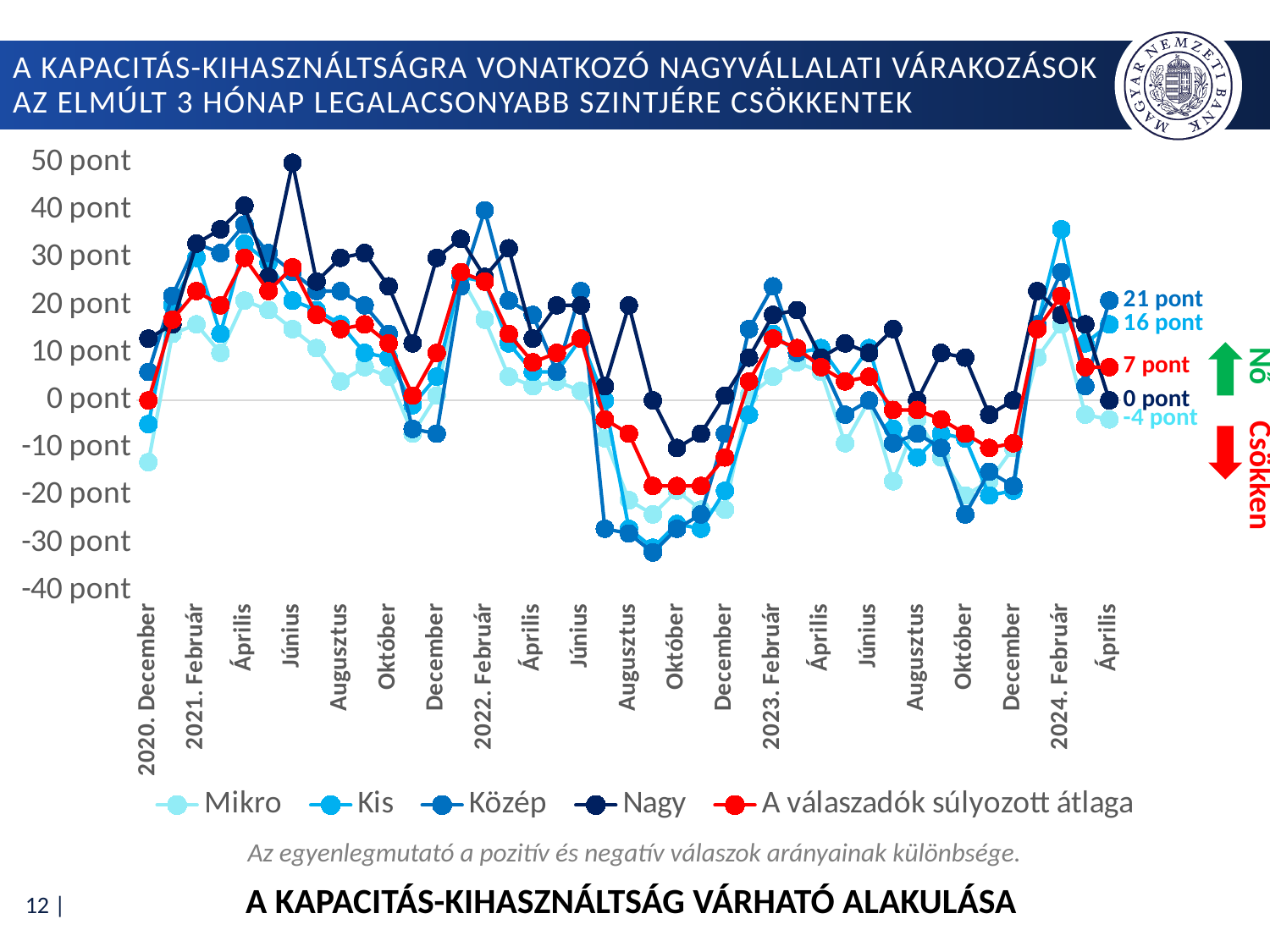
Is the Nagy value in 2021 June greater or less than 40 pont? greater What is the value labelled at the end of the Kis line (2024 April)? 16 pont What is the title of the chart shown below the legend? A KAPACITÁS-KIHASZNÁLTSÁG VÁRHATÓ ALAKULÁSA Which series has the lowest value at the last point (2024 April)? Mikro What kind of chart is shown on the slide? line chart What is the difference between the Közép and Kis values at the last point (2024 April)? 5 pont What is the value labelled at the end of the Nagy line (2024 April)? 0 pont Which series has the highest value at the last point (2024 April)? Közép How many series does the legend list? 5 What is the value labelled at the end of the Közép line (2024 April)? 21 pont What is the value labelled at the end of the Mikro line (2024 April)? -4 pont What is the value labelled at the end of the line for A válaszadók súlyozott átlaga (2024 April)? 7 pont